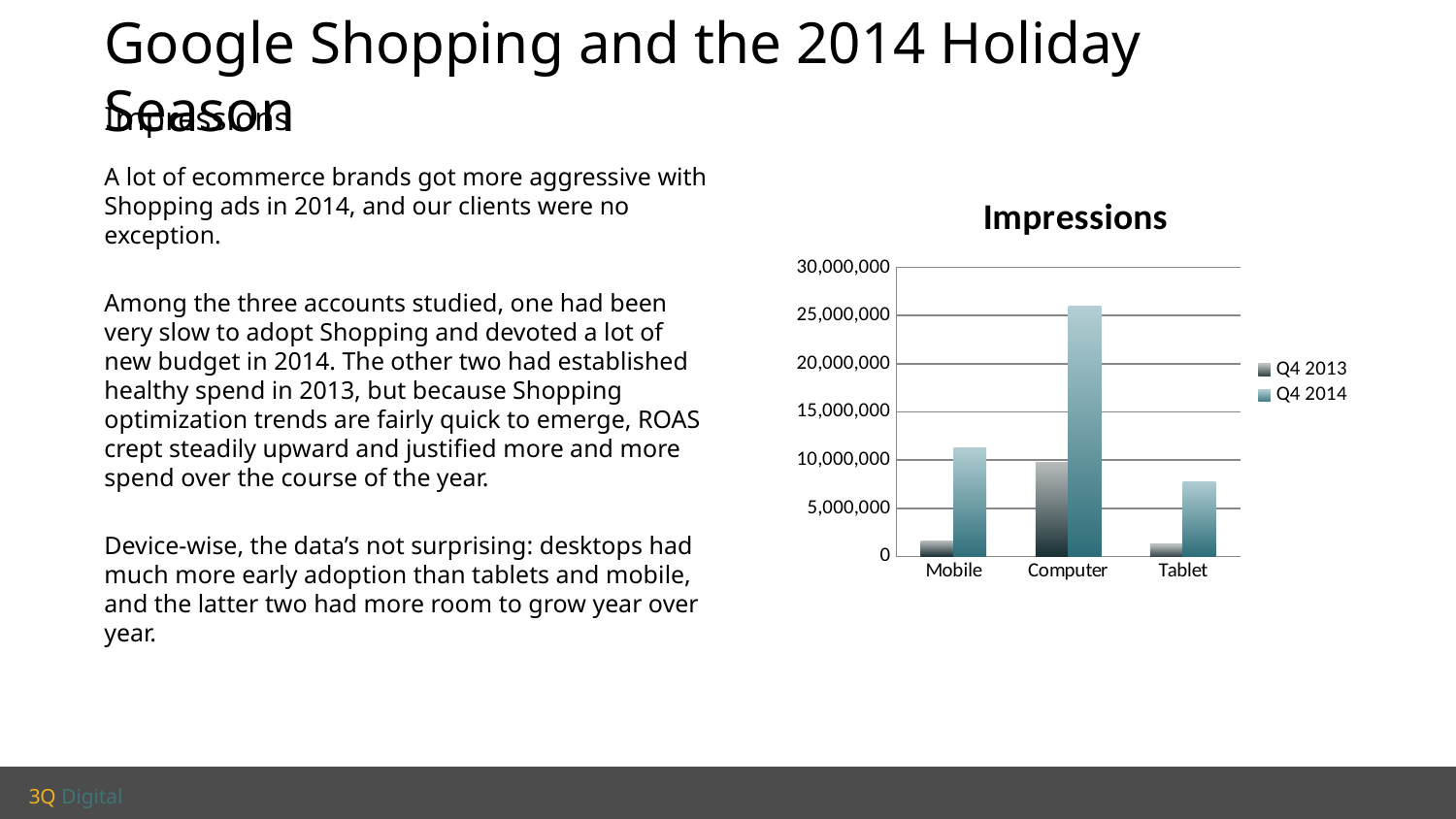
What is the title of the chart? Impressions For Computer, which quarter has more impressions, Q4 2013 or Q4 2014? Q4 2014 Is the Q4 2014 value for Tablet greater or less than 5,000,000? greater Which device category has the highest Q4 2014 impressions? Computer What type of chart is shown on the slide? Bar chart How many device categories are shown on the x axis of the chart? 3 Is the Q4 2014 value for Computer greater or less than 20,000,000? greater Is the Q4 2013 value for Mobile greater or less than 5,000,000? less For Q4 2014, which has more impressions, Mobile or Tablet? Mobile Which device category has the highest Q4 2013 impressions? Computer How many series does the chart legend list? 2